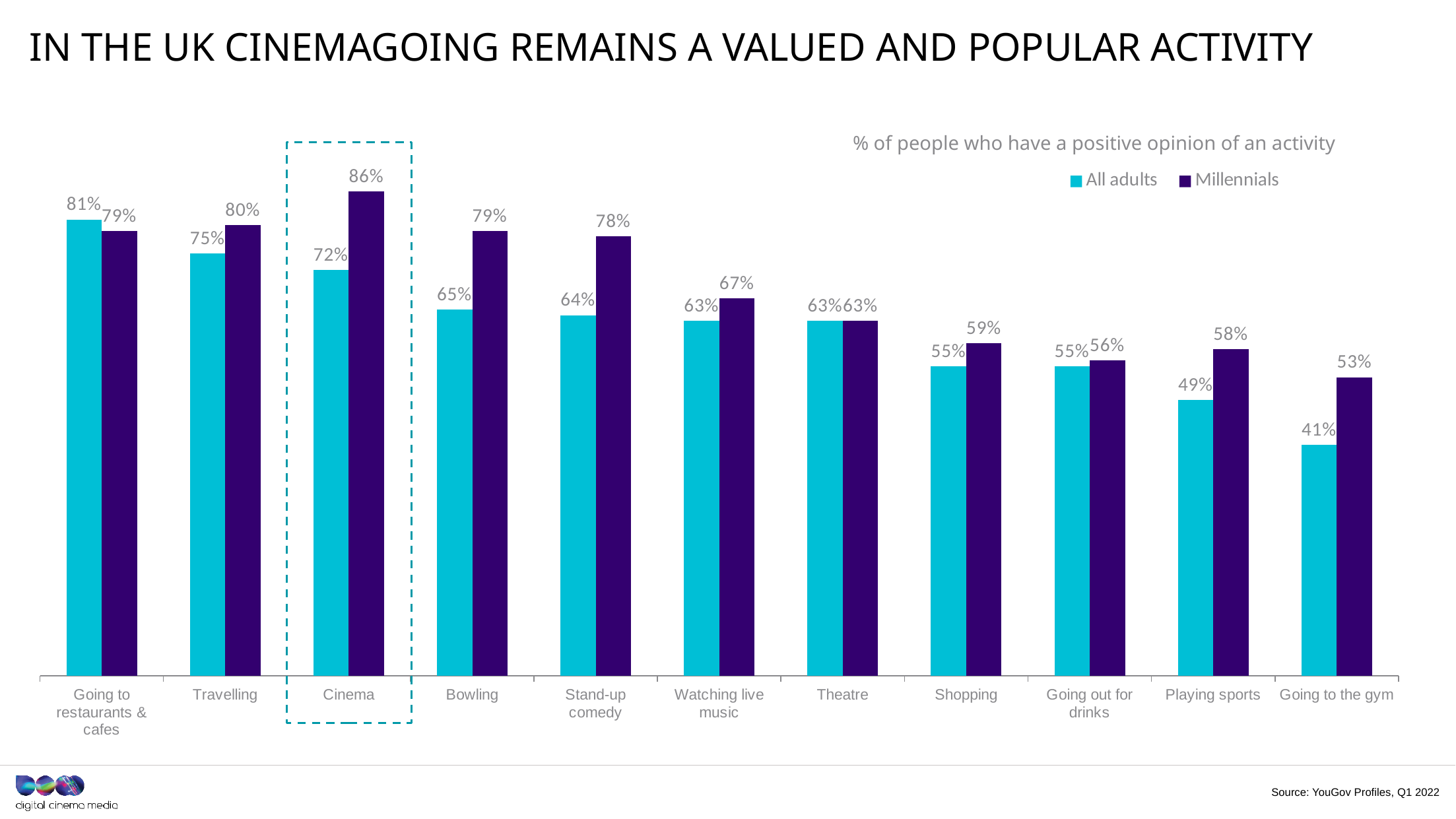
Which activity has the lowest All adults value? Going to the gym Which activity is highlighted with a dashed box? Cinema How many activities are shown on the x axis? 11 What is the difference between the All adults values for Going to restaurants & cafes and Going to the gym? 40% What is the difference between the Millennials and All adults values for Cinema? 14% What kind of chart is shown on the slide? Bar chart What percentage of All adults have a positive opinion of Cinema? 72% What is the Millennials value for Stand-up comedy? 78% How many series does the legend list? 2 Which activity has the highest Millennials value? Cinema Which is larger for Going to restaurants & cafes: the All adults value or the Millennials value? All adults What percentage of Millennials have a positive opinion of Cinema? 86%